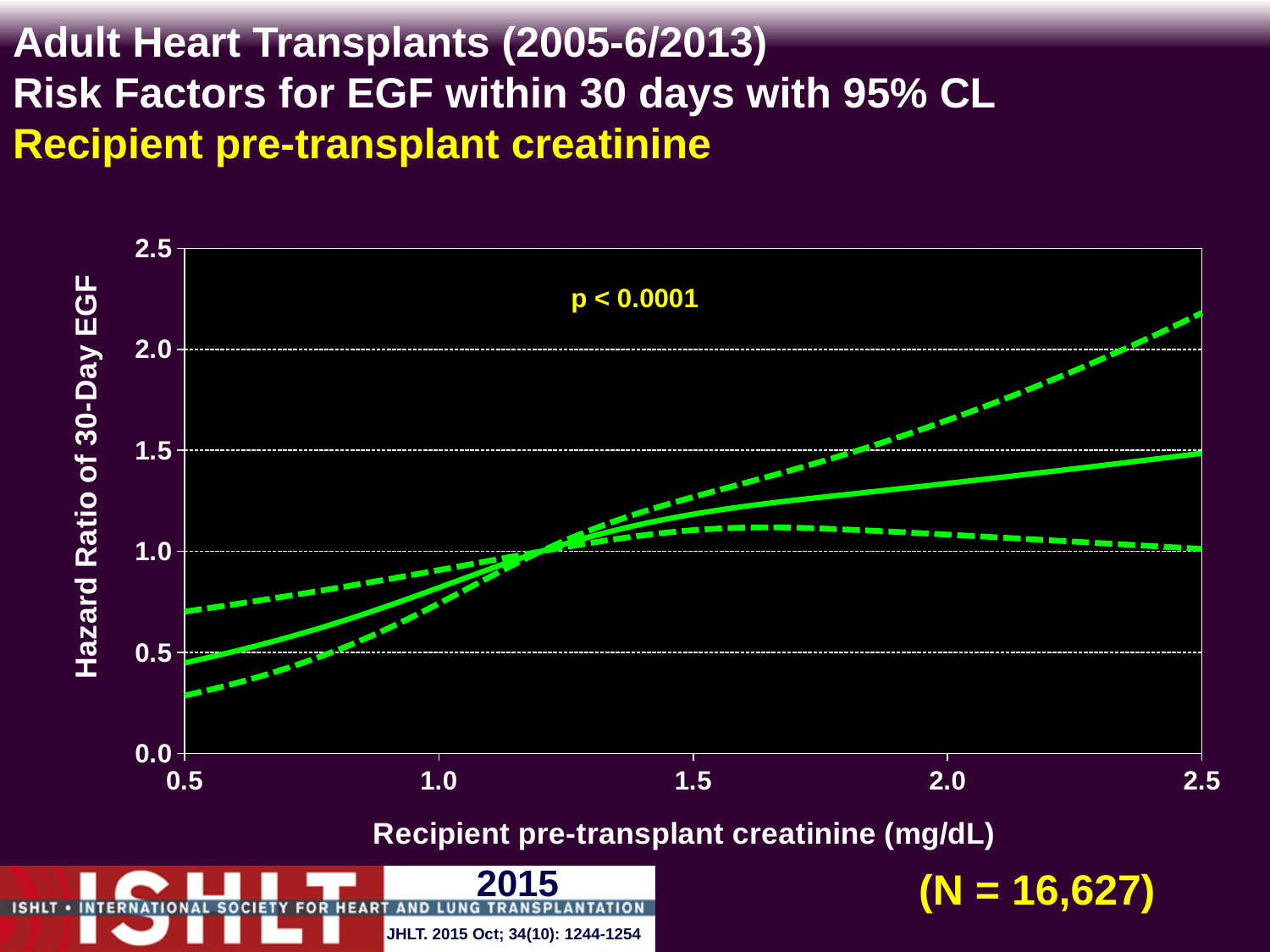
Is the hazard ratio (solid line) at a creatinine of 2.0 mg/dL greater or less than 1.0? greater Is the upper 95% confidence limit (upper dashed line) at a creatinine of 0.5 mg/dL greater or less than 0.5? greater Is the upper 95% confidence limit (upper dashed line) at a creatinine of 2.5 mg/dL greater or less than 2.0? greater What p-value is printed on the chart? p < 0.0001 Does the hazard ratio of 30-day EGF rise or fall as recipient pre-transplant creatinine increases from 0.5 to 2.5 mg/dL? Rise What is the label of the x axis? Recipient pre-transplant creatinine (mg/dL) How many lines are plotted on the chart? 3 What is the sample size (N) shown on the slide? N = 16,627 What kind of chart is shown on the slide? Line chart